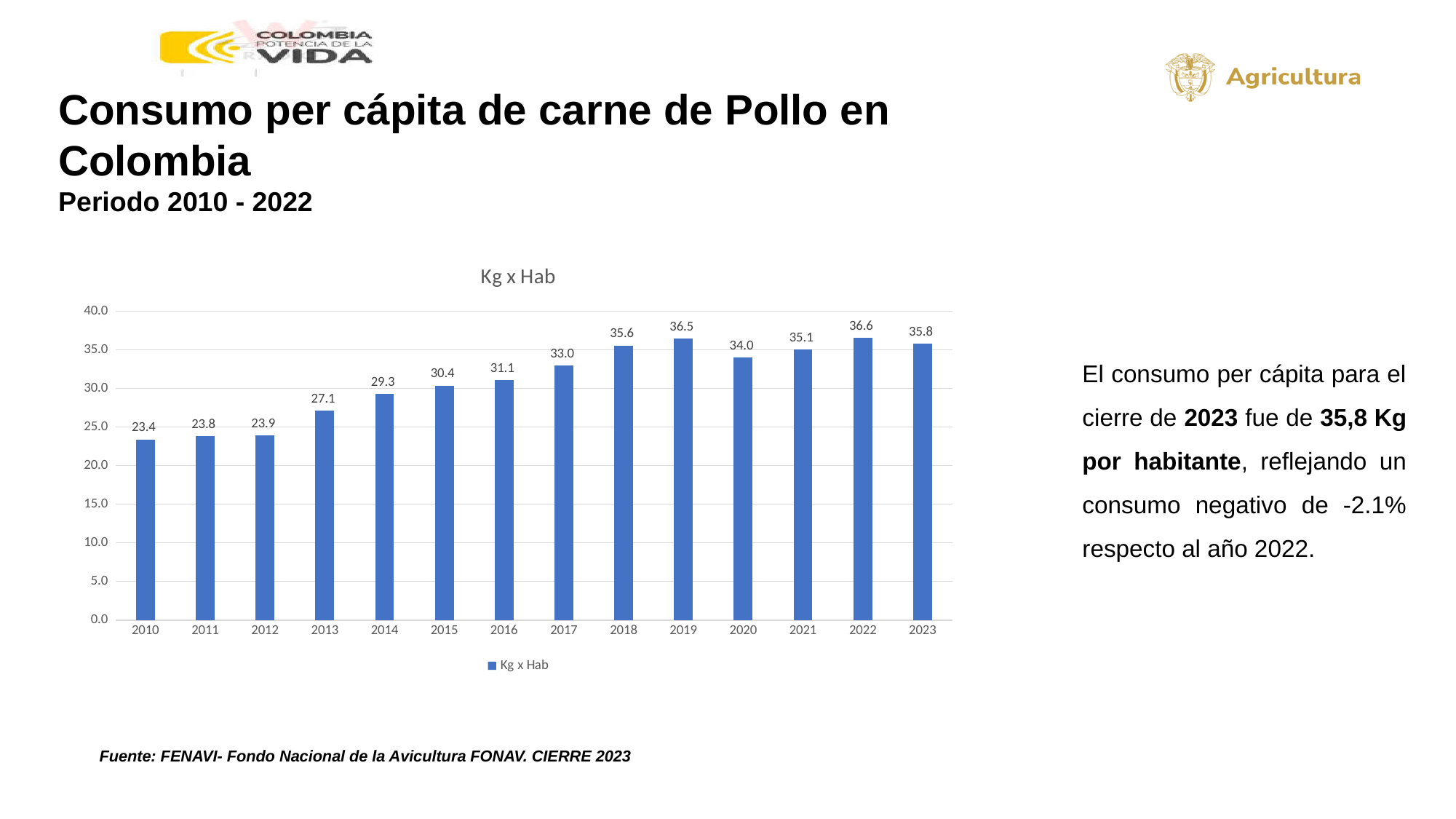
Which is larger in the Kg x Hab chart, the value for 2020 or the value for 2021? 2021 What is the value for 2019 in the Kg x Hab chart? 36.5 How many years are shown on the x axis of the Kg x Hab chart? 14 Is the value for 2017 in the Kg x Hab chart greater or less than 30.0? greater Which year has the highest value in the Kg x Hab chart? 2022 Do the values in the Kg x Hab chart generally rise or fall from 2010 to 2019? Rise What kind of chart is the Kg x Hab chart? Bar chart What is the difference between the values for 2022 and 2023 in the Kg x Hab chart? 0.8 What is the value for 2010 in the Kg x Hab chart? 23.4 Which year has the lowest value in the Kg x Hab chart? 2010 What is the value for 2023 in the Kg x Hab chart? 35.8 How many series does the legend of the Kg x Hab chart list? 1